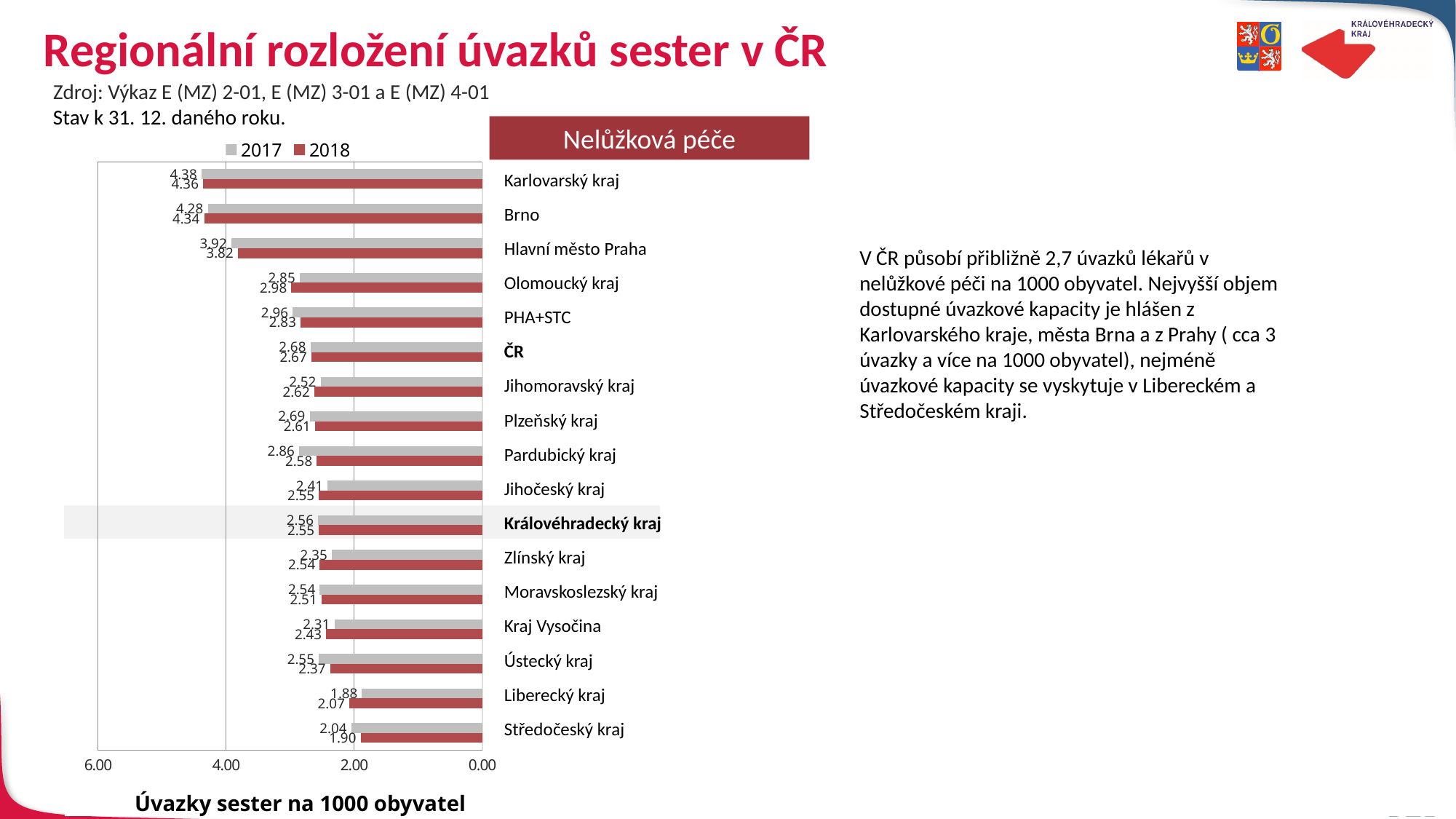
Is the 2018 value for Brno greater or less than 4.00? greater What is the 2018 value for Královéhradecký kraj? 2.55 Which is larger for Olomoucký kraj, the 2017 value or the 2018 value? 2018 Which region has the lowest 2018 value? Středočeský kraj What type of chart is shown on the slide? bar chart Which region has the lowest 2017 value? Liberecký kraj How many categories (regions) are plotted in the chart? 17 What is the difference between the 2017 and 2018 values for Pardubický kraj? 0.28 What is the 2017 value for Hlavní město Praha? 3.92 What is the x-axis label of the chart? Úvazky sester na 1000 obyvatel How many series does the chart legend list? 2 What is the 2018 value for ČR? 2.67